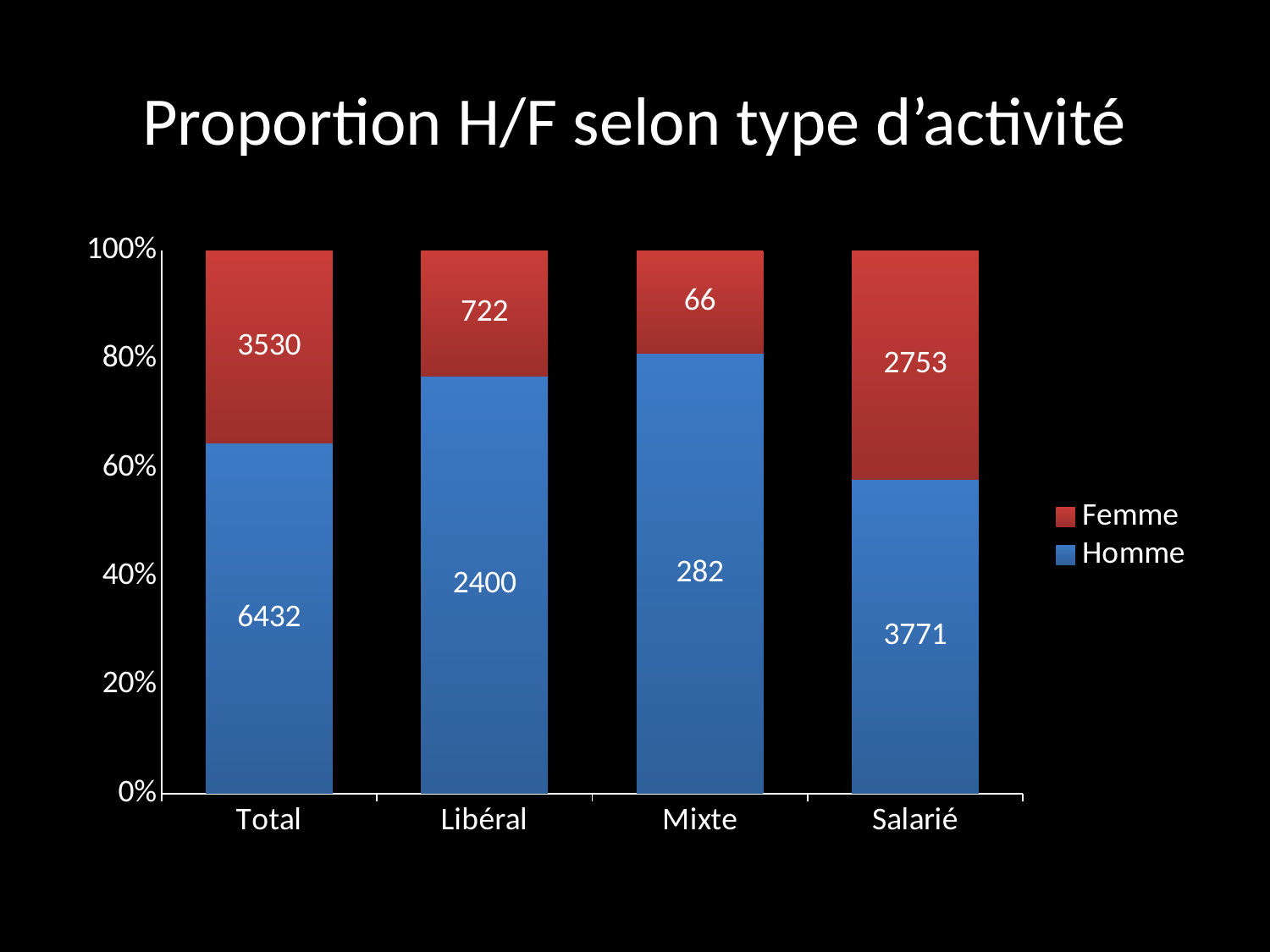
Which category has the highest Femme value? Total What is the Homme value for Libéral? 2400 What is the difference between the Femme value for Total and the Femme value for Salarié? 777 What is the Femme value for Mixte? 66 How many series does the legend list? 2 Is the Homme share of the Salarié bar greater or less than 60%? less What is the Femme value for Salarié? 2753 What type of chart is shown? stacked bar chart What is the Homme value for Total? 6432 Which category has the lowest Homme value? Mixte Which is larger, the Homme value for Salarié or the Homme value for Libéral? Salarié What is the combined Homme and Femme count for Libéral? 3122